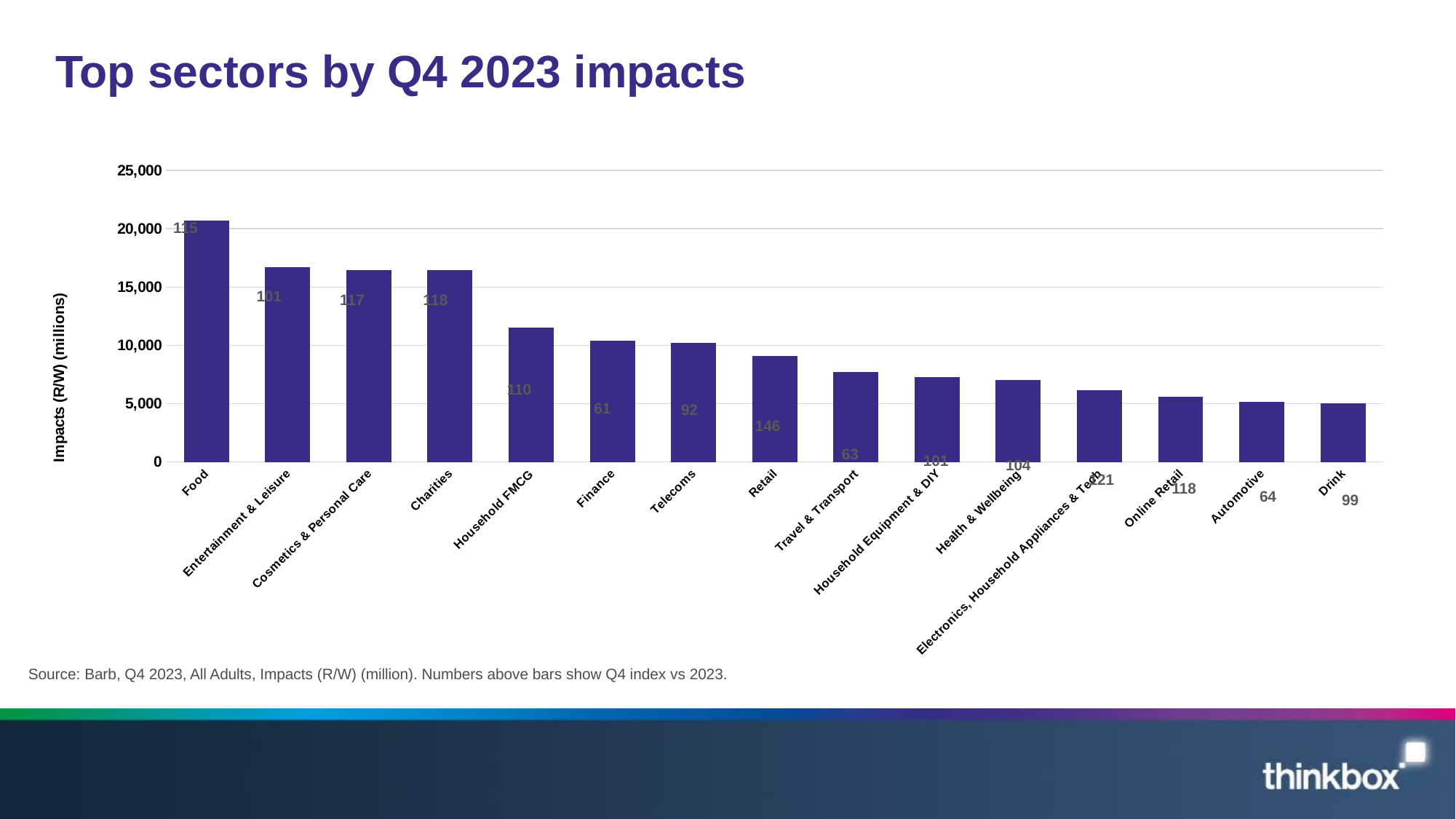
How many sectors are plotted in the chart? 15 Is the value for Retail greater or less than 10,000? less What Q4 index vs 2023 is shown for Finance? 61 What kind of chart is shown on the slide? bar chart What Q4 index vs 2023 is shown above the Retail bar? 146 Is the value for Entertainment & Leisure greater or less than 15,000? greater Is the value for Travel & Transport greater or less than 5,000? greater Which has higher impacts, Household FMCG or Retail? Household FMCG Do the impacts values rise or fall moving from left to right across the sectors? fall What is the title of the vertical axis? Impacts (R/W) (millions) Which sector has the highest Q4 2023 impacts? Food